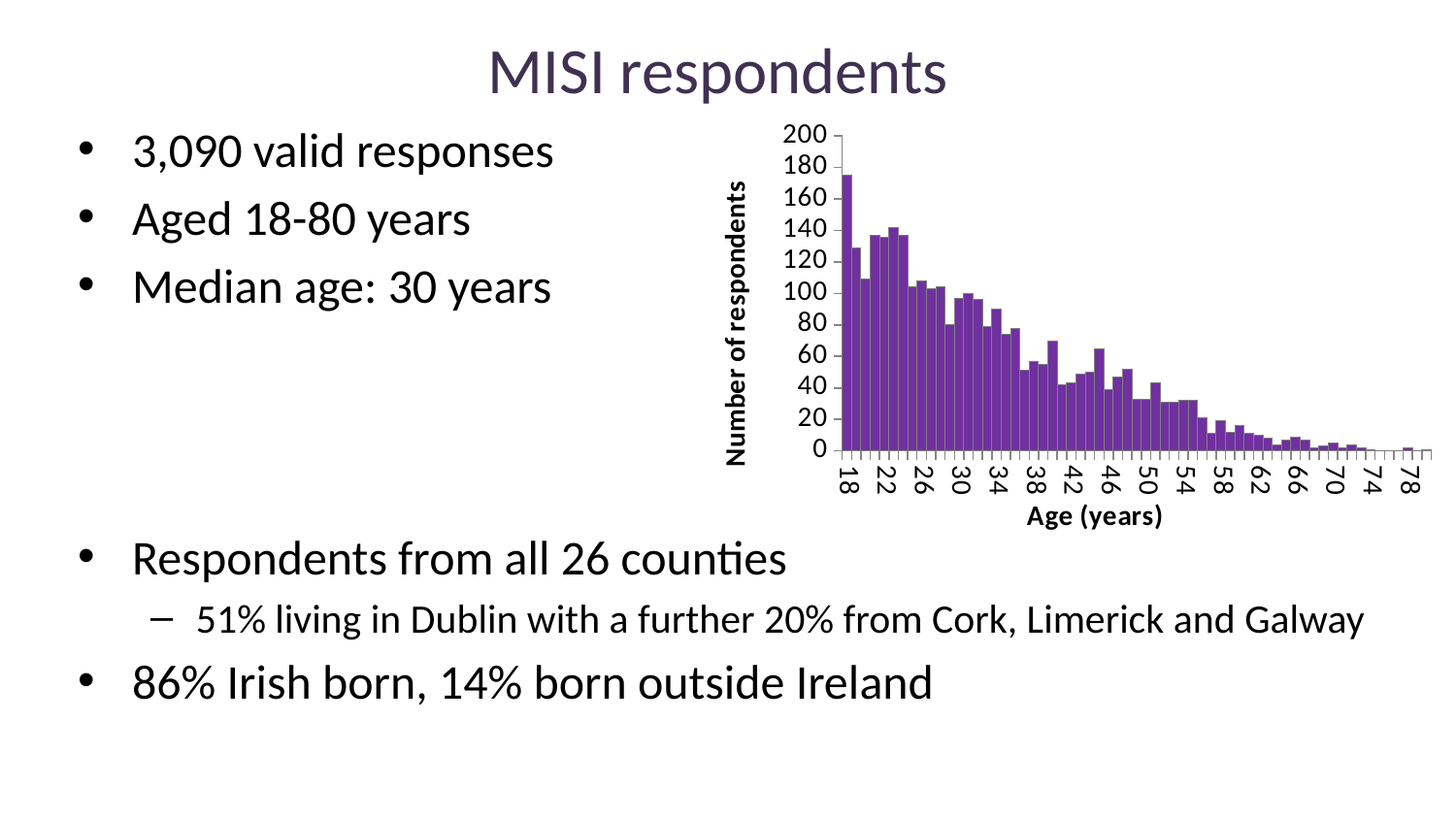
What is the label of the vertical axis of the chart? Number of respondents Is the number of respondents aged 50 greater or less than 40? less What is the label of the horizontal axis of the chart? Age (years) Is the number of respondents aged 30 greater or less than 80? greater Is the number of respondents aged 22 greater or less than 120? greater Which age has more respondents, 22 or 42? 22 What kind of chart is shown on the slide? bar chart Which age has more respondents, 18 or 30? 18 Overall, do the number of respondents rise or fall as age increases along the x axis? fall Which age has the highest number of respondents? 18